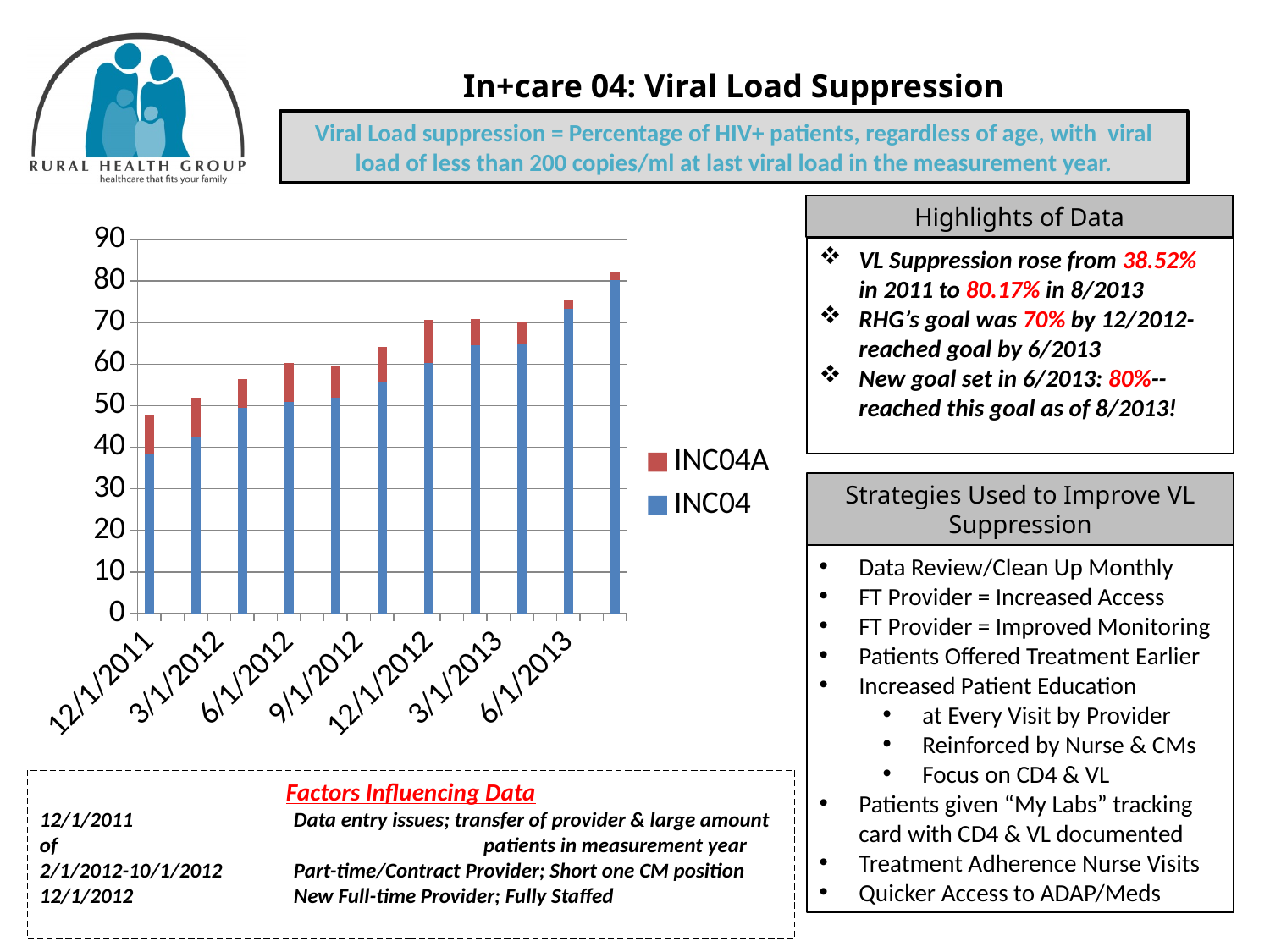
Which is larger, the stacked total of the 12/1/2011 bar or the stacked total of the rightmost bar? the rightmost bar How many bars are plotted in the chart? 11 How many series does the chart legend list? 2 What are the two series named in the chart legend? INC04A and INC04 Which bar has the lowest stacked total in the chart? 12/1/2011 Which bar has the highest stacked total in the chart? the rightmost bar What kind of chart is shown on the slide? bar chart Is the stacked total of the rightmost bar greater or less than 70? greater Which colour represents the INC04 series in the chart? blue Is the stacked total of the 12/1/2011 bar greater or less than 50? less Do the stacked bar totals generally rise or fall from left to right along the x axis? rise Is the INC04 (blue) value for 12/1/2011 greater or less than 30? greater